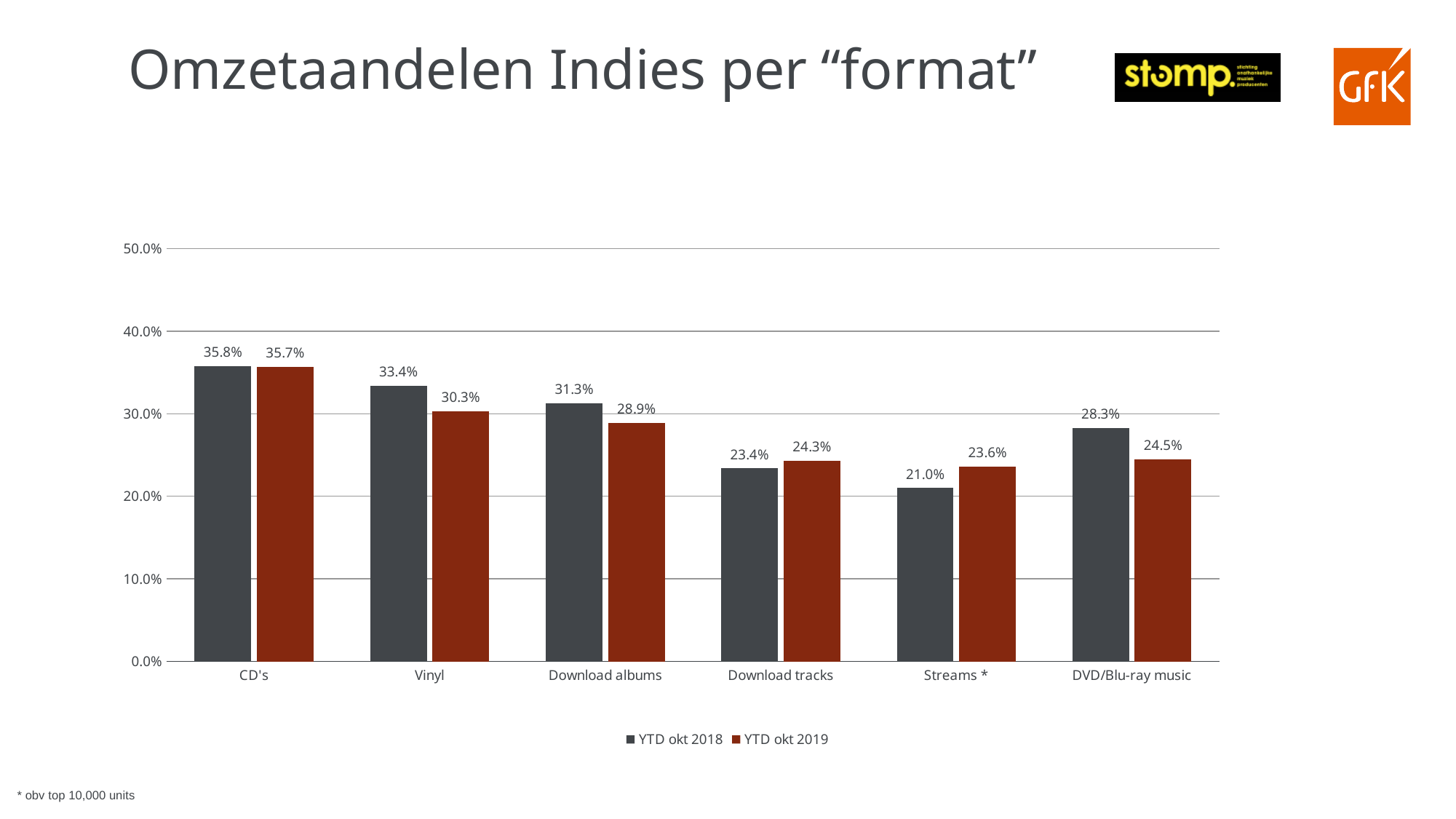
What is the difference between the YTD okt 2018 and YTD okt 2019 values for Download albums? 2.4% Which category has the lowest value in the YTD okt 2019 series? Streams * Which category has the highest value in the YTD okt 2018 series? CD's For Download tracks, which series has the larger value: YTD okt 2018 or YTD okt 2019? YTD okt 2019 Is the YTD okt 2018 value for DVD/Blu-ray music greater or less than 30.0%? less What kind of chart is shown on the slide? bar chart How many categories are shown on the x axis? 6 What is the value for Streams * in the YTD okt 2018 series? 21.0% How many series does the legend list? 2 What is the value for DVD/Blu-ray music in the YTD okt 2019 series? 24.5% What is the title of the slide? Omzetaandelen Indies per “format” What is the value for Vinyl in the YTD okt 2019 series? 30.3%